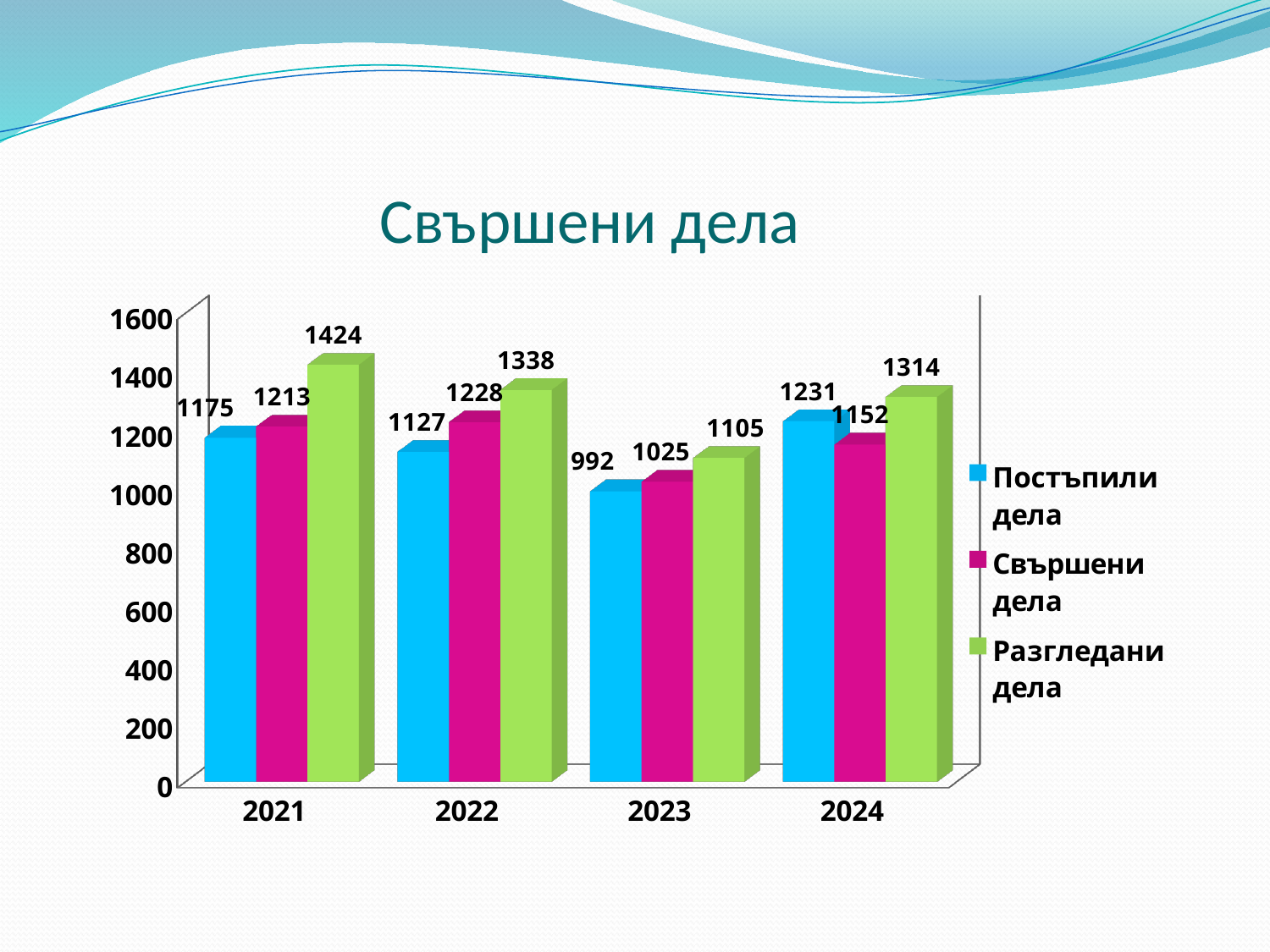
Which year has the highest value for Разгледани дела? 2021 What is the value for Постъпили дела in 2023? 992 What is the title of the chart? Свършени дела Which is larger: Свършени дела in 2021 or Свършени дела in 2022? 2022 What is the value for Свършени дела in 2024? 1152 What is the difference between Разгледани дела and Свършени дела in 2022? 110 How many series does the legend list? 3 Is the value for Постъпили дела in 2024 greater or less than 1200? greater How many years are shown on the x axis? 4 What kind of chart is shown on the slide? bar chart What is the value for Разгледани дела in 2021? 1424 Which year has the lowest value for Постъпили дела? 2023